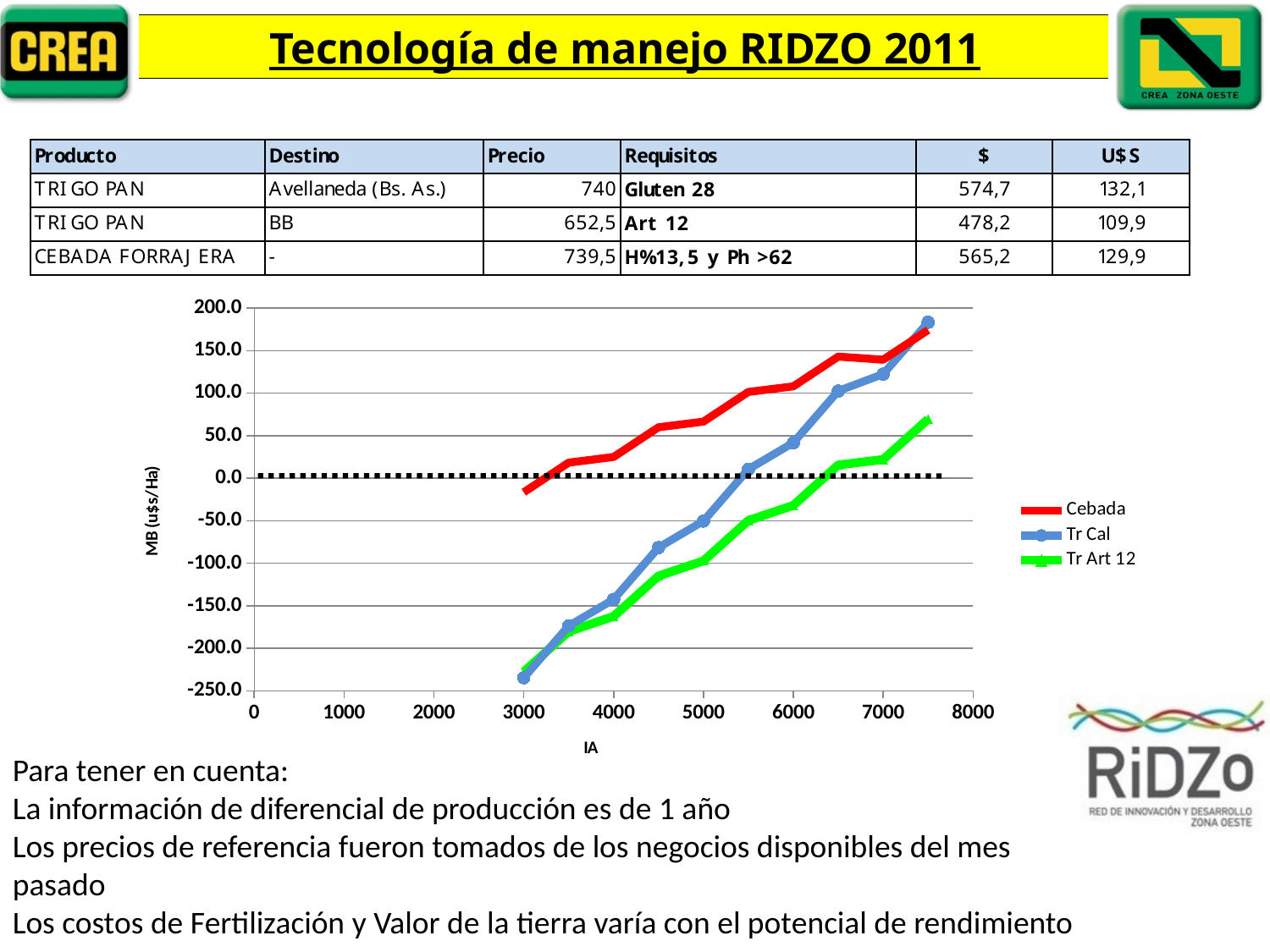
Which series are listed in the chart legend? Cebada, Tr Cal, Tr Art 12 What kind of chart is shown on the slide? line chart Is the value of the Tr Cal series at IA 3000 greater or less than -200? less Is the value of the Tr Art 12 series at IA 7500 greater or less than 50? greater At IA 4000, which series has the highest value? Cebada Is the value of the Tr Cal series at IA 6000 greater or less than 0? greater At IA 7500, which series has the larger value, Tr Cal or Tr Art 12? Tr Cal At IA 5000, which series has the larger value, Cebada or Tr Art 12? Cebada How many series does the chart legend list? 3 What is the label of the chart's vertical axis? MB (u$s/Ha) Do the values of the Cebada series rise or fall as IA increases? rise